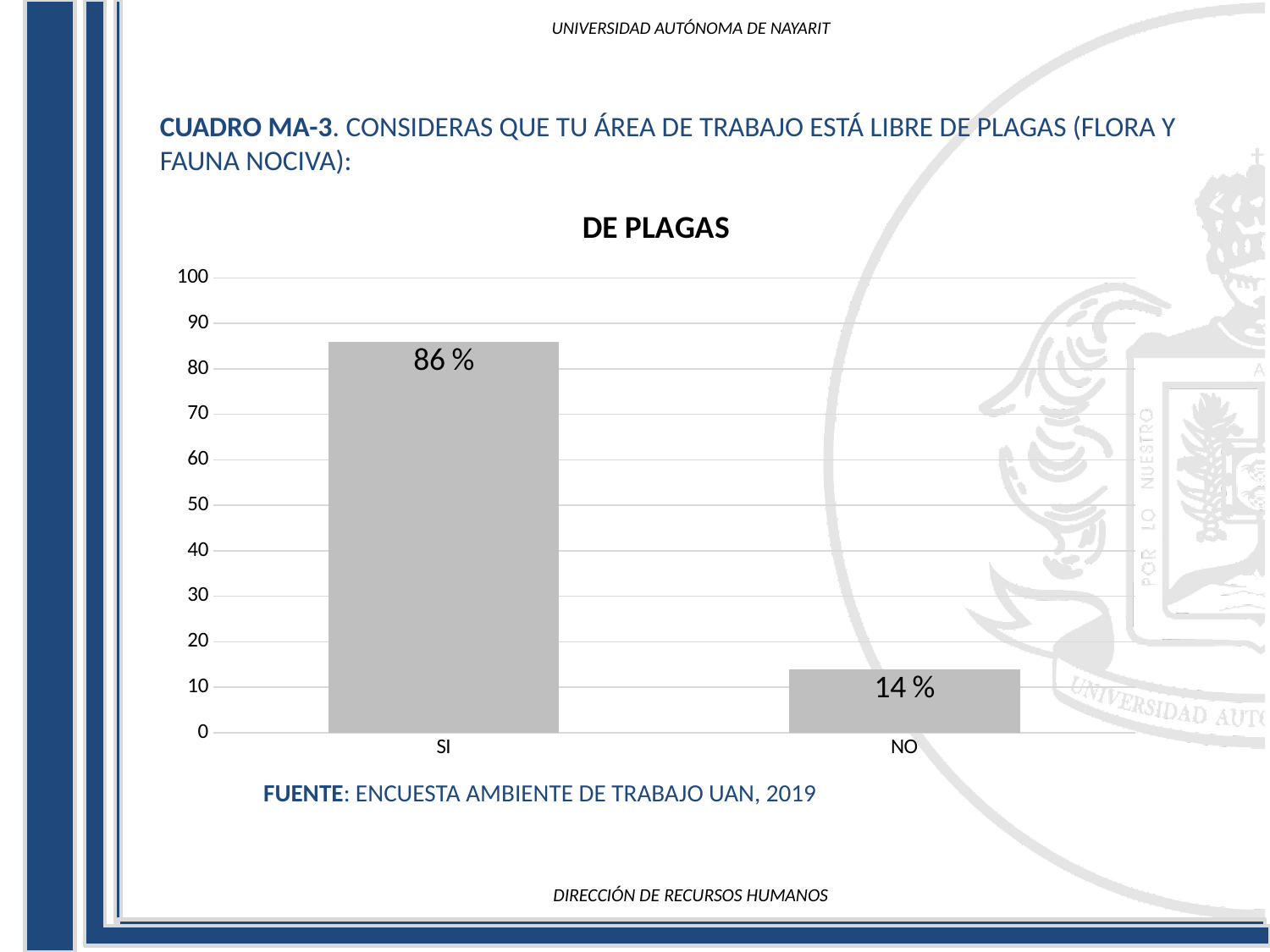
Is the value for NO greater or less than 20? less What is the value for SI? 86 % Is the value for SI greater or less than 80? greater What is the difference between the values for SI and NO? 72 % Which category has the lowest value? NO Which is larger, the value for SI or the value for NO? SI How many categories are shown on the x axis? 2 What is the value for NO? 14 % What is the title of the chart? DE PLAGAS What is the highest value shown on the y axis? 100 Which category has the highest value? SI What kind of chart is shown on the slide? bar chart